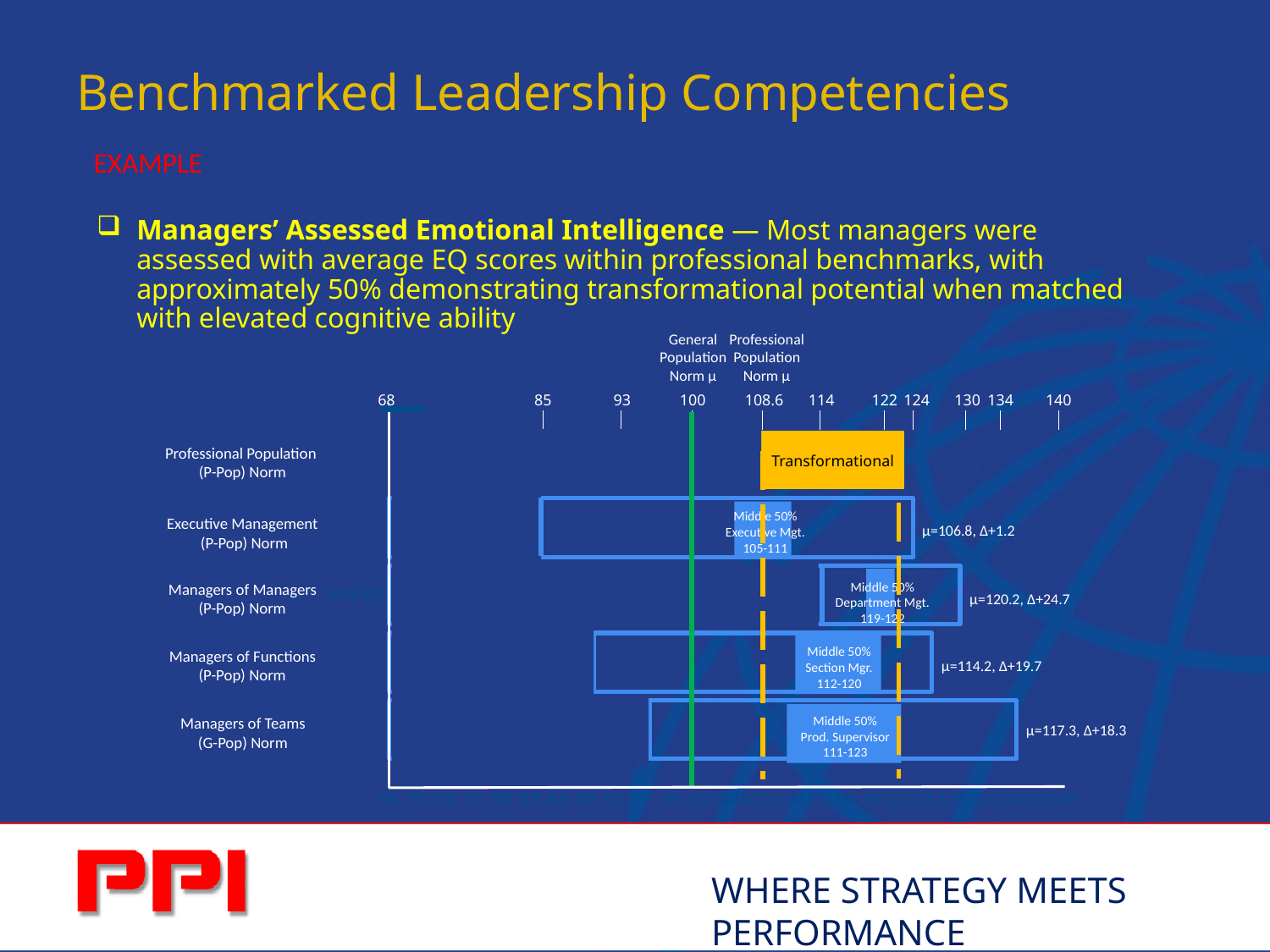
What axis value is labelled as the General Population Norm μ? 100 What is the mean (μ) value shown for Executive Management (P-Pop) Norm? 106.8 What is the difference between the mean (μ) for Managers of Managers and the mean (μ) for Executive Management? 13.4 Which management group has the lowest mean (μ) value shown? Executive Management (P-Pop) Norm Which has a larger mean (μ): Managers of Teams or Managers of Functions? Managers of Teams Which management group has the highest mean (μ) value shown? Managers of Managers (P-Pop) Norm What is the Middle 50% range labelled for Department Mgt. (Managers of Managers)? 119-122 What is the Δ value shown for Managers of Functions (P-Pop) Norm? +19.7 What is the Middle 50% range labelled for Prod. Supervisor (Managers of Teams)? 111-123 What axis value is labelled as the Professional Population Norm μ? 108.6 What is the mean (μ) value shown for Managers of Managers (P-Pop) Norm? 120.2 How many management groups (rows) are plotted on the chart? 5